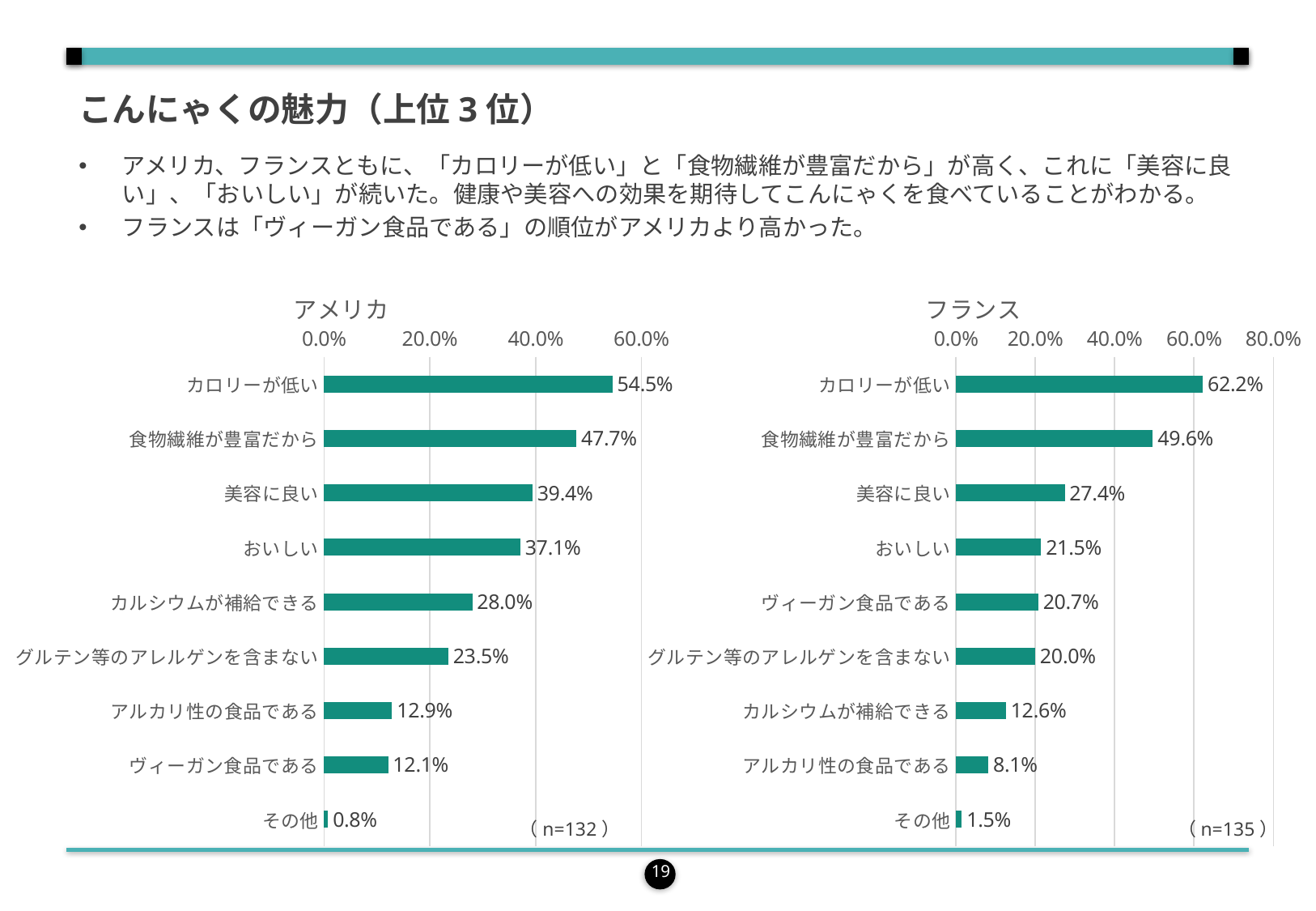
In the フランス chart, which category has the highest value? カロリーが低い In the アメリカ chart, what is the difference between 美容に良い and おいしい? 2.3% In the アメリカ chart, which category has the lowest value? その他 In the フランス chart, what is the value for ヴィーガン食品である? 20.7% What sample size (n) is shown for the フランス chart? n=135 What kind of chart is the フランス chart? bar chart Which is larger: 美容に良い in the アメリカ chart or 美容に良い in the フランス chart? アメリカ How many categories does the アメリカ chart show? 9 In the フランス chart, is the value for おいしい greater or less than 40.0%? less In the フランス chart, what is the difference between カロリーが低い and 食物繊維が豊富だから? 12.6% In the アメリカ chart, what is the value for カロリーが低い? 54.5% In the アメリカ chart, what is the value for カルシウムが補給できる? 28.0%